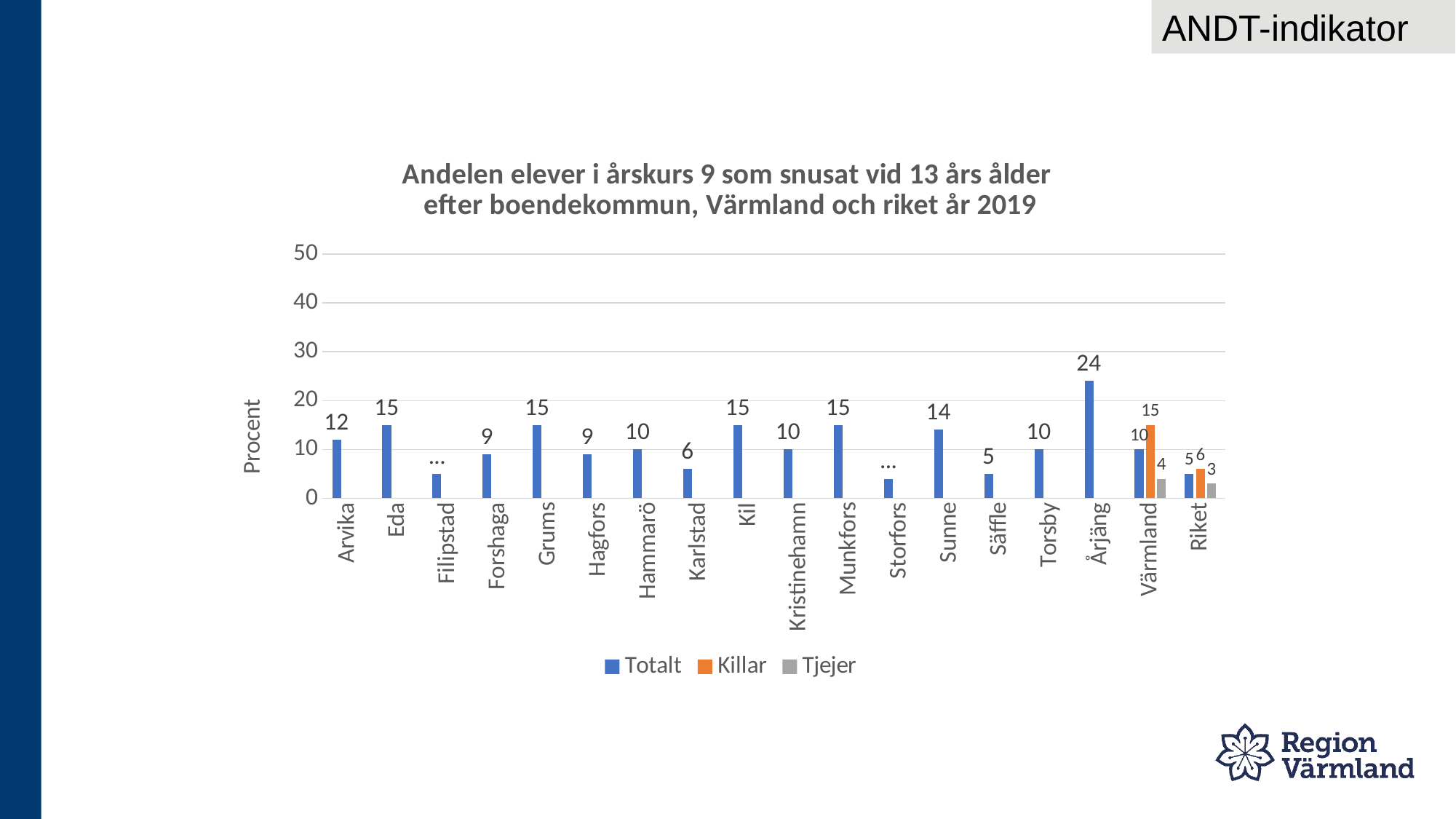
What kind of chart is shown on the slide? Bar chart What is the difference between the Killar and Tjejer values for Värmland? 11 How many categories are shown on the x axis? 18 Is the Totalt value for Årjäng greater or less than 20? greater What is the Killar value for Värmland? 15 What is the Totalt value for Årjäng? 24 Which municipality has the highest Totalt value? Årjäng What is the Tjejer value for Riket? 3 What is the Totalt value for Karlstad? 6 What is the difference between the Totalt values for Årjäng and Arvika? 12 Which has a larger Totalt value, Sunne or Säffle? Sunne How many series does the legend list? 3